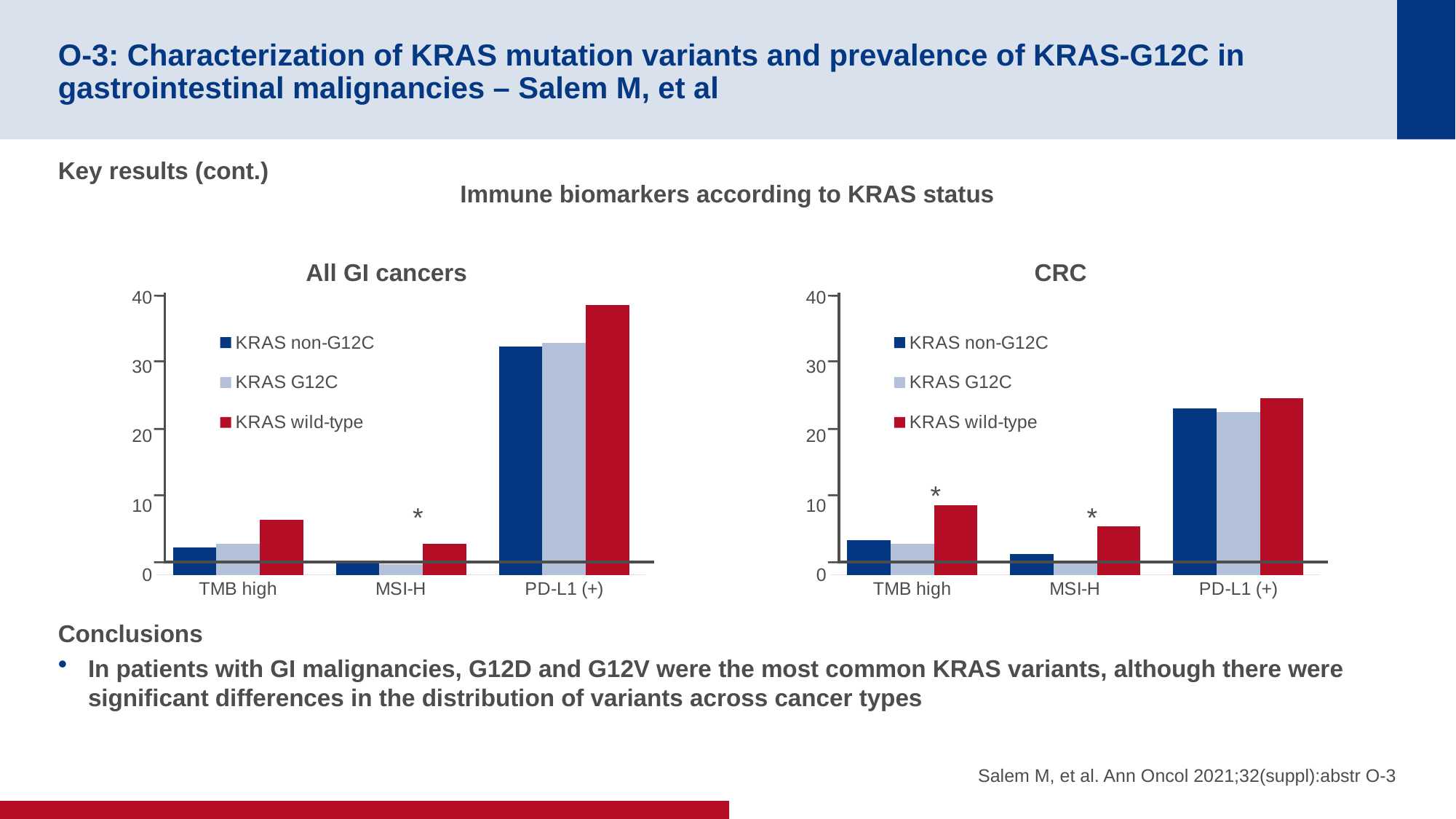
In the 'All GI cancers' chart, for PD-L1 (+), which is larger: KRAS wild-type or KRAS non-G12C? KRAS wild-type In the 'CRC' chart, is the KRAS wild-type value for PD-L1 (+) greater or less than 30? less In the 'All GI cancers' chart, which category has the highest KRAS wild-type bar? PD-L1 (+) In the 'All GI cancers' chart, which category has the lowest KRAS wild-type bar? MSI-H In the 'All GI cancers' chart, is the KRAS wild-type value for TMB high greater or less than 10? less What is the title of the chart on the right side of the slide? CRC How many categories are shown on the x axis of the 'CRC' chart? 3 In the 'CRC' chart, for TMB high, which is larger: KRAS wild-type or KRAS G12C? KRAS wild-type In the 'All GI cancers' chart, is the KRAS wild-type value for PD-L1 (+) greater or less than 30? greater What kind of chart is the 'All GI cancers' chart? bar chart How many series does the legend of the 'All GI cancers' chart list? 3